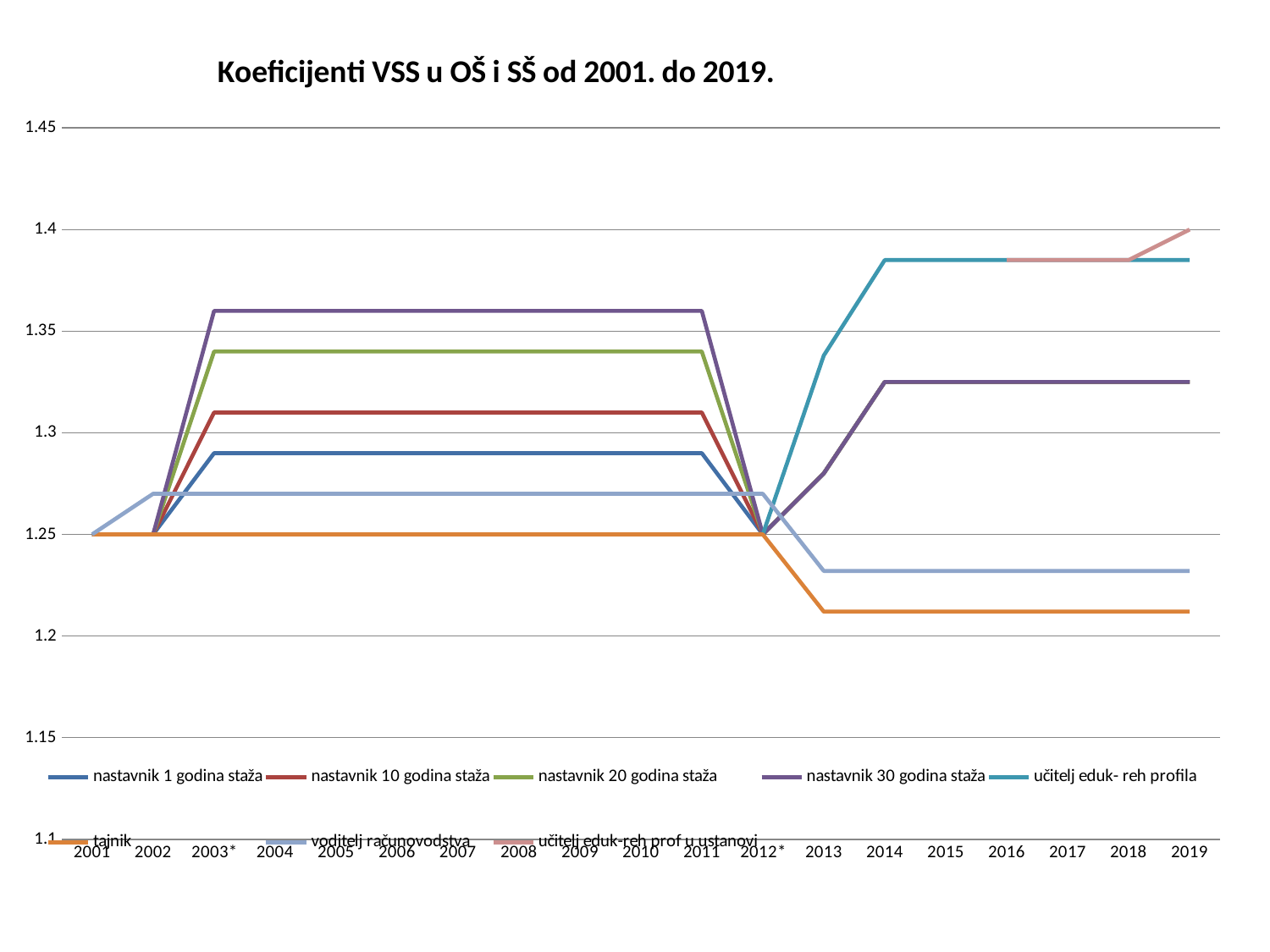
Is the value for nastavnik 30 godina staža in 2005 greater or less than 1.35? greater How many years are shown along the x axis? 19 What is the value for učitelj eduk-reh prof u ustanovi in 2019? 1.4 What is the value for tajnik in 2005? 1.25 What kind of chart is shown on the slide? line chart Which series has the lowest value in 2015? tajnik How many series does the legend list? 8 What is the title of the chart? Koeficijenti VSS u OŠ i SŠ od 2001. do 2019. In 2015, which is larger: nastavnik 30 godina staža or voditelj računovodstva? nastavnik 30 godina staža Is the value for voditelj računovodstva in 2015 greater or less than 1.25? less Which series has the highest value in 2005? nastavnik 30 godina staža Does the value for tajnik rise or fall from 2012* to 2013? fall